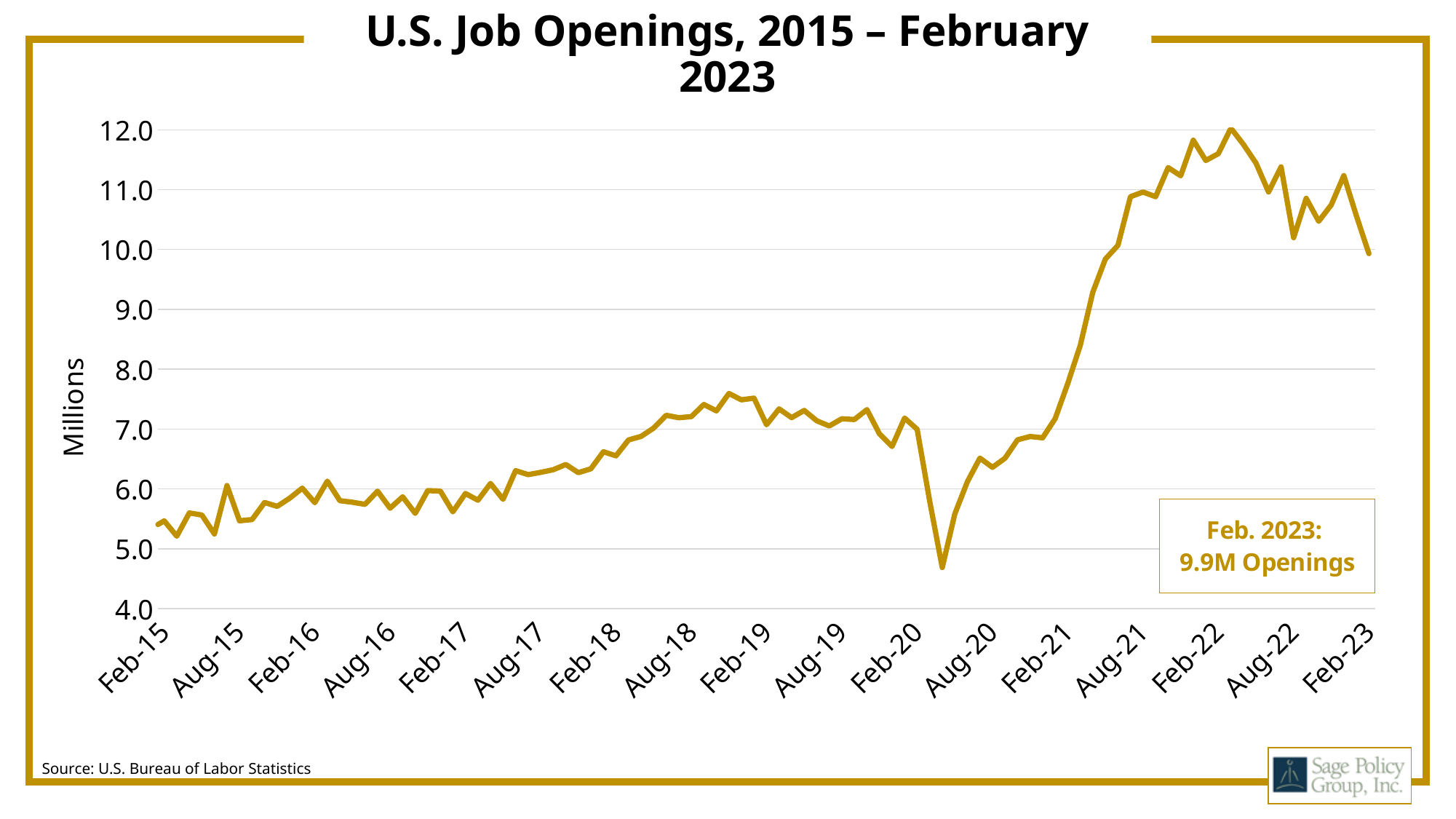
In which year does the line reach its lowest point? 2020 Is the value for Feb-18 greater or less than 7.0? less What is the label on the vertical axis? Millions What kind of chart is shown on the slide? line chart Does the line generally rise or fall from Feb-15 to Feb-19? rise Is the value for Feb-15 greater or less than 6.0? less Is the value for Aug-20 greater or less than 7.0? less In which year does the line reach its highest point? 2022 According to the annotation, how many job openings were there in February 2023? 9.9M Does the line generally rise or fall from Aug-22 to Feb-23? fall